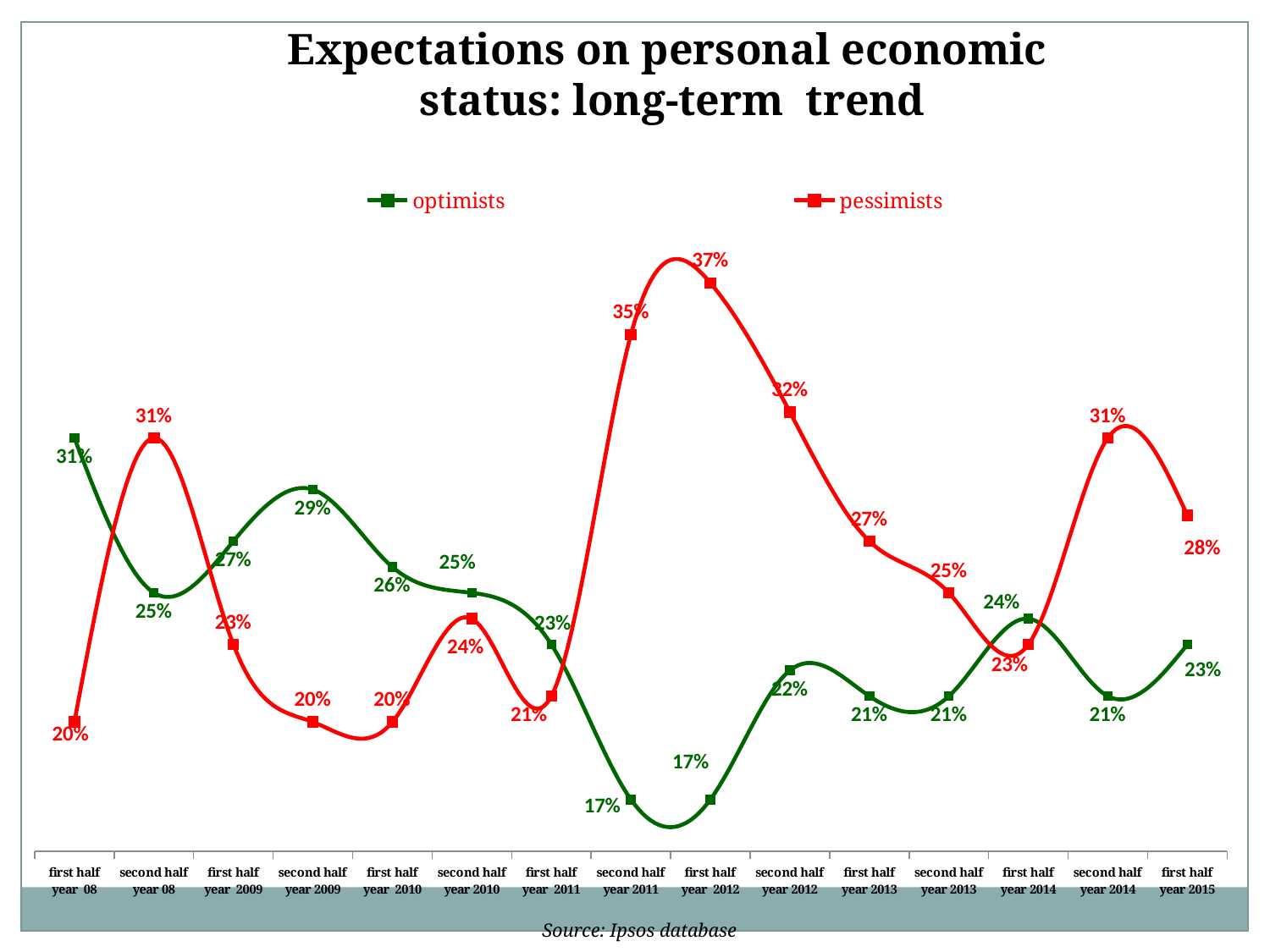
In which period do optimists reach their highest value? first half year 08 Do the pessimists values rise or fall from first half year 2012 to first half year 2014? fall How many periods are shown on the x axis? 15 In second half year 2014, which series has the larger value, optimists or pessimists? pessimists What is the value for pessimists in first half year 2012? 37% In which period do pessimists reach their highest value? first half year 2012 What is the value for optimists in first half year 2015? 23% In first half year 2012, how much higher is the pessimists value than the optimists value? 20 percentage points What colour is the pessimists line? red What kind of chart is shown on the slide? line chart How many series does the legend list? 2 What is the value for optimists in second half year 2009? 29%